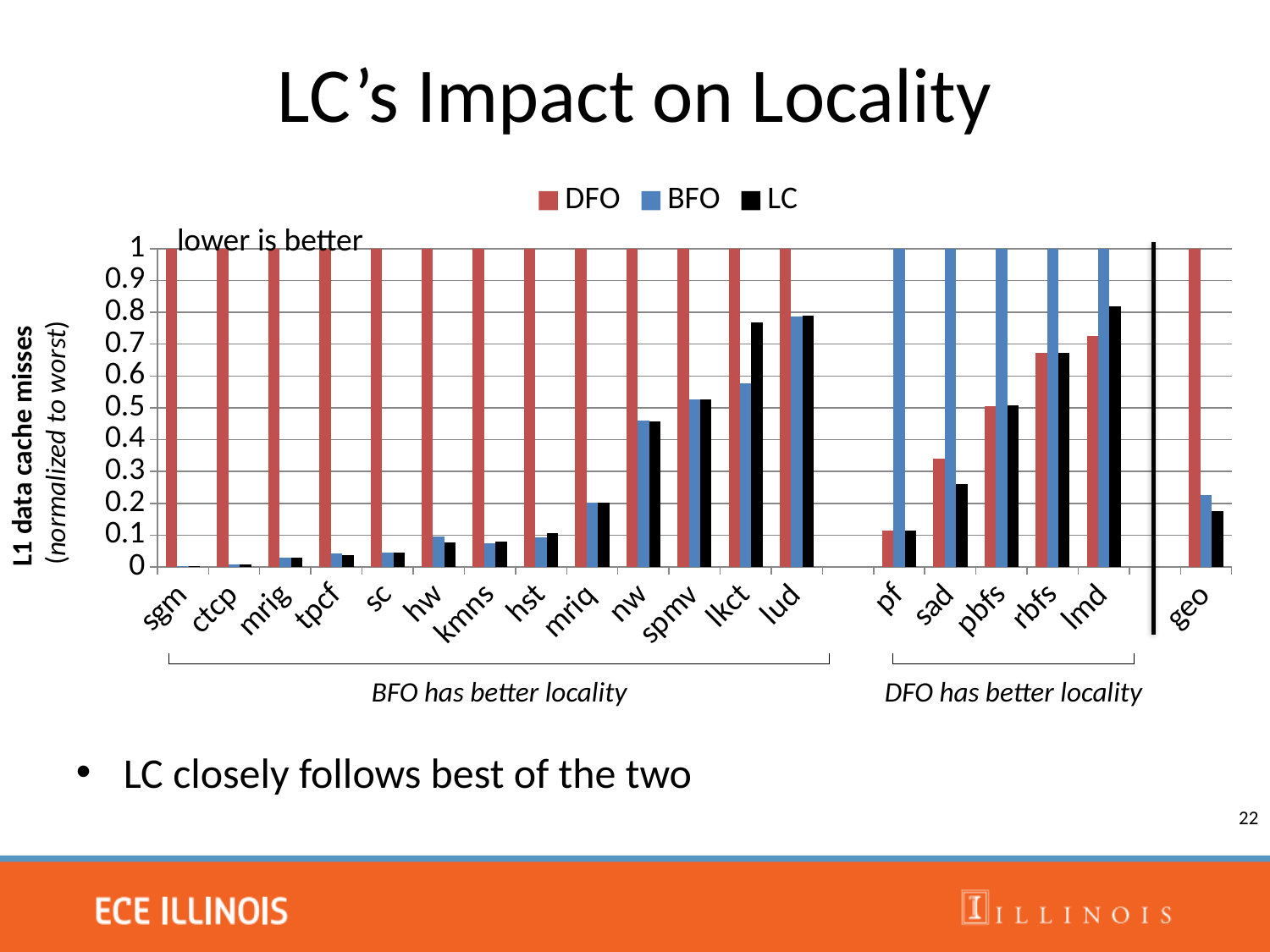
Which is larger for sgm, the DFO value or the BFO value? DFO Is the LC value for geo greater or less than 0.3? less Is the BFO value for nw greater or less than 0.5? less Is the BFO value for lud greater or less than 0.7? greater What is the DFO value for geo? 1 What is the BFO value for pf? 1 How many categories are shown on the x axis? 19 How many series does the legend list? 3 What is the DFO value for sgm? 1 What kind of chart is shown on the slide? bar chart Which series has the highest value for pbfs? BFO